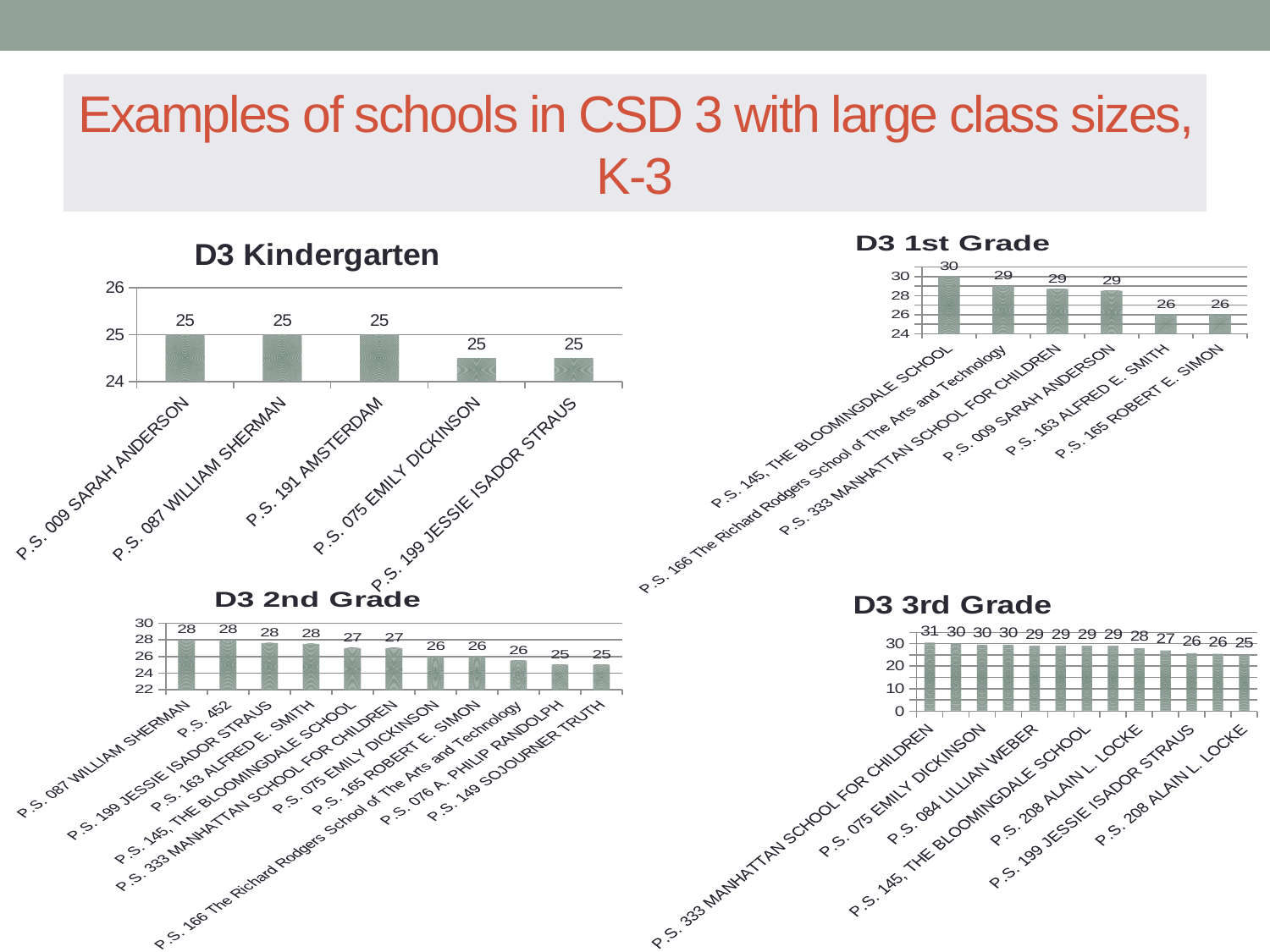
How many schools are shown in the D3 2nd Grade chart? 11 In the D3 1st Grade chart, which school has the highest value? P.S. 145, THE BLOOMINGDALE SCHOOL In the D3 2nd Grade chart, do the values rise or fall from left to right? fall How many schools are shown in the D3 Kindergarten chart? 5 In the D3 Kindergarten chart, what is the value for P.S. 191 AMSTERDAM? 25 How many schools are shown in the D3 1st Grade chart? 6 What kind of chart is the D3 Kindergarten chart? bar chart In the D3 1st Grade chart, what is the difference between the values for P.S. 145, THE BLOOMINGDALE SCHOOL and P.S. 165 ROBERT E. SIMON? 4 In the D3 2nd Grade chart, which is larger: the value for P.S. 087 WILLIAM SHERMAN or the value for P.S. 076 A. PHILIP RANDOLPH? P.S. 087 WILLIAM SHERMAN In the D3 3rd Grade chart, what is the highest value shown? 31 In the D3 1st Grade chart, what is the value for P.S. 145, THE BLOOMINGDALE SCHOOL? 30 In the D3 2nd Grade chart, what is the value for P.S. 149 SOJOURNER TRUTH? 25